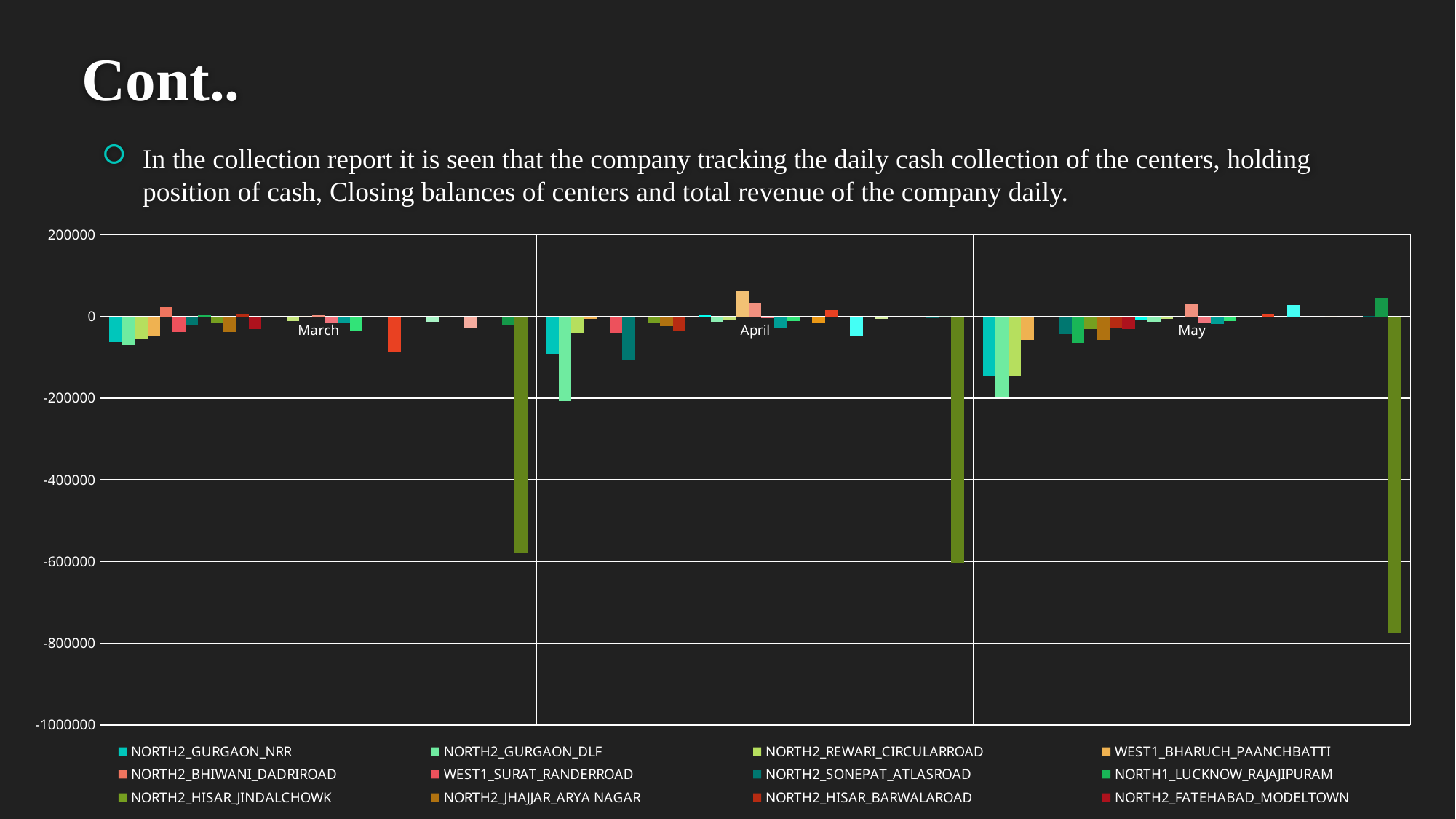
How many series does the chart's legend list? 12 How many months are shown on the x axis of the chart? 3 What kind of chart is shown on the slide? bar chart Which series in the legend is shown in olive green? NORTH2_HISAR_JINDALCHOWK What is the first series listed in the chart's legend? NORTH2_GURGAON_NRR Is the value for NORTH2_GURGAON_NRR in May greater or less than -200000? greater